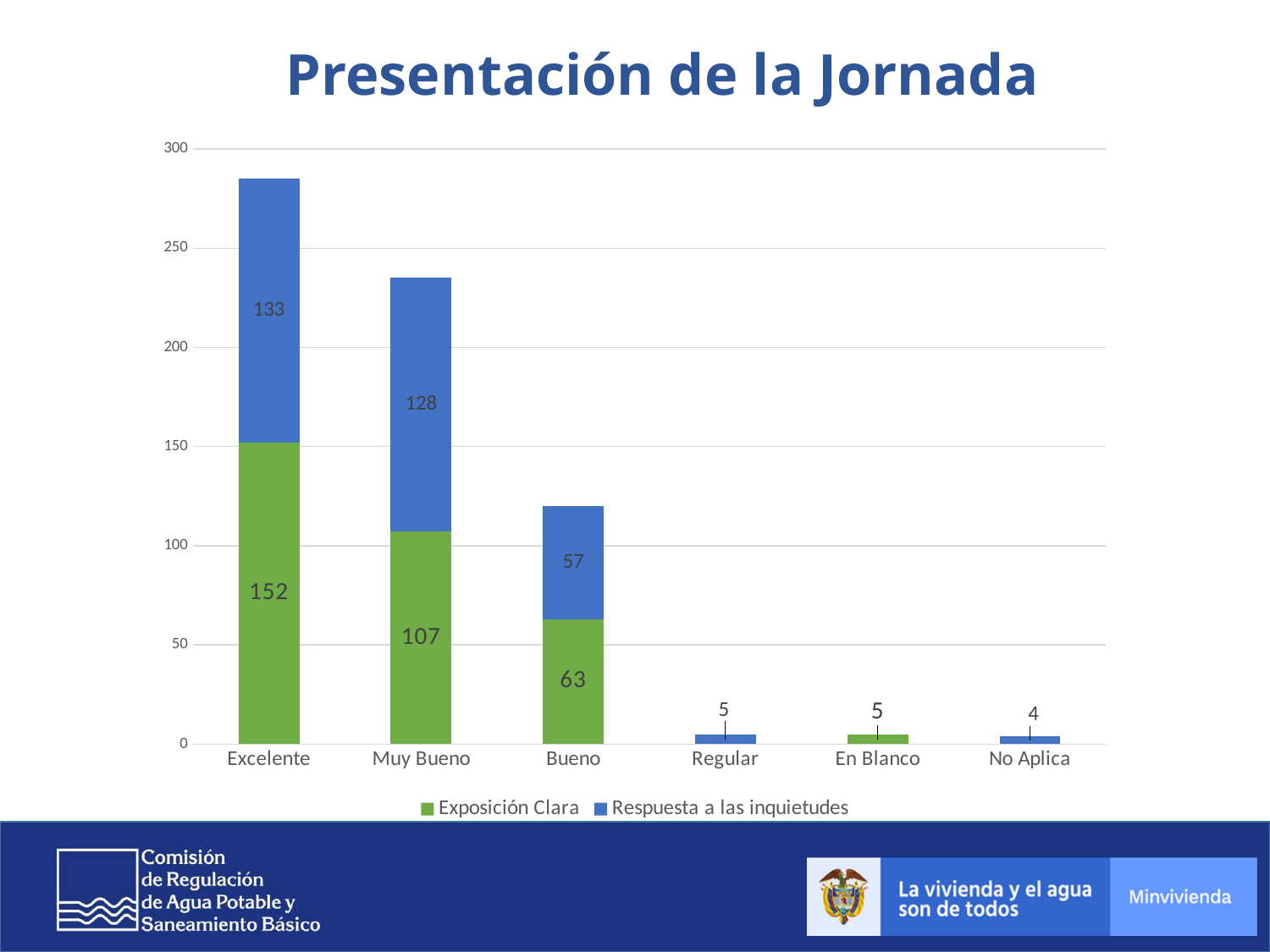
Which is larger for Muy Bueno: Exposición Clara or Respuesta a las inquietudes? Respuesta a las inquietudes Which category has the highest Exposición Clara value? Excelente What is the value of Exposición Clara for Excelente? 152 What kind of chart is shown on the slide? Stacked bar chart How many categories are shown on the x axis? 6 Is the total stacked value for Muy Bueno greater or less than 200? greater What is the total of the stacked bar for Bueno? 120 What is the value of Respuesta a las inquietudes for Bueno? 57 How many series does the legend list? 2 What is the value of Respuesta a las inquietudes for Muy Bueno? 128 What is the total of the stacked bar for Excelente? 285 What is the difference between the Exposición Clara values for Excelente and Muy Bueno? 45